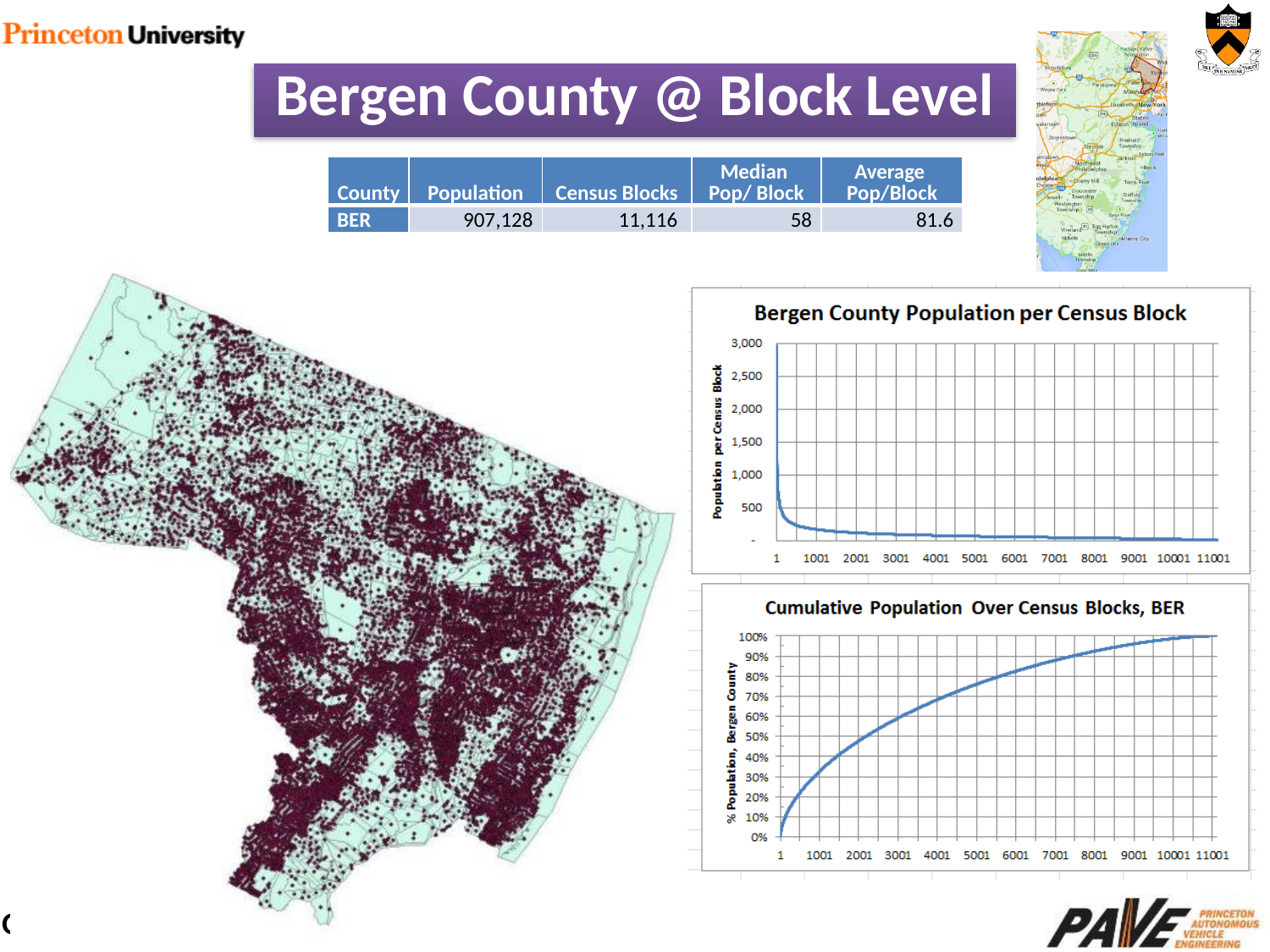
In the 'Cumulative Population Over Census Blocks, BER' chart, do the values rise or fall as you move along the x axis? rise In the 'Cumulative Population Over Census Blocks, BER' chart, is the value at census block 9001 greater or less than 80%? greater In the 'Bergen County Population per Census Block' chart, is the value at census block 6001 greater or less than 500? less What is the y-axis label of the 'Cumulative Population Over Census Blocks, BER' chart? % Population, Bergen County What kind of chart is the 'Cumulative Population Over Census Blocks, BER' chart? line chart In the 'Bergen County Population per Census Block' chart, is the value at census block 1 greater or less than 2,500? greater In the 'Cumulative Population Over Census Blocks, BER' chart, what value does the curve reach at the far right end of the x axis? 100% What is the highest value shown on the y axis of the 'Bergen County Population per Census Block' chart? 3,000 What kind of chart is the 'Bergen County Population per Census Block' chart? line chart In the 'Bergen County Population per Census Block' chart, do the values rise or fall as you move along the x axis? fall